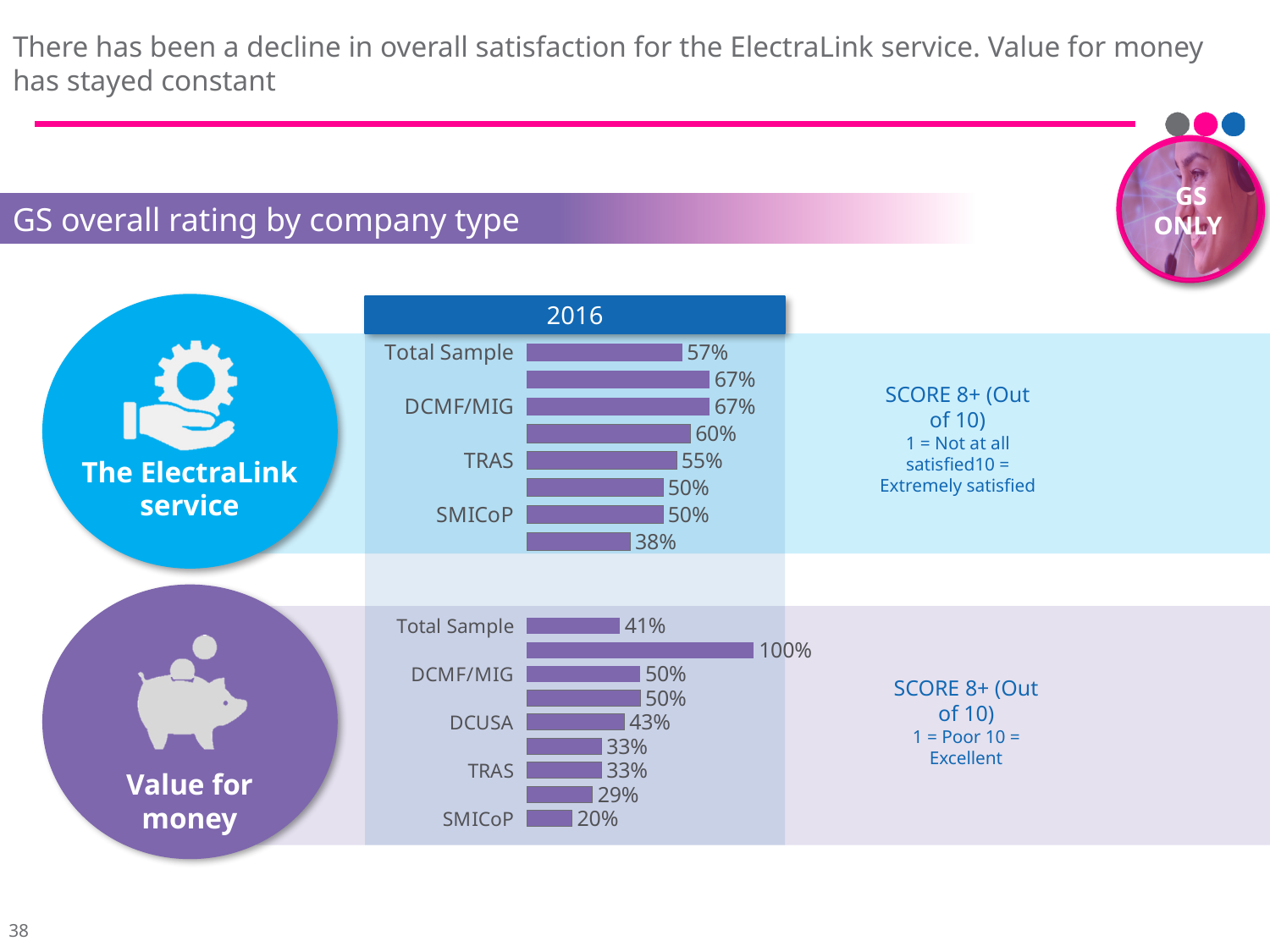
What kind of chart is used for The ElectraLink service ratings? bar chart In the Value for money chart, what is the value for Total Sample? 41% What is the difference between the Total Sample value for The ElectraLink service and the Total Sample value for Value for money? 16 percentage points In the Value for money chart, what is the value for DCUSA? 43% In The ElectraLink service chart, what is the lowest value shown? 38% In the Value for money chart, what is the highest value shown? 100% In The ElectraLink service chart, what is the highest value shown? 67% Which year is shown in the header above the charts? 2016 Which is larger: the Total Sample value for The ElectraLink service or the Total Sample value for Value for money? The ElectraLink service In the Value for money chart, what is the lowest value shown? 20% In the Value for money chart, what is the value for SMICoP? 20% In The ElectraLink service chart, what is the value for Total Sample? 57%